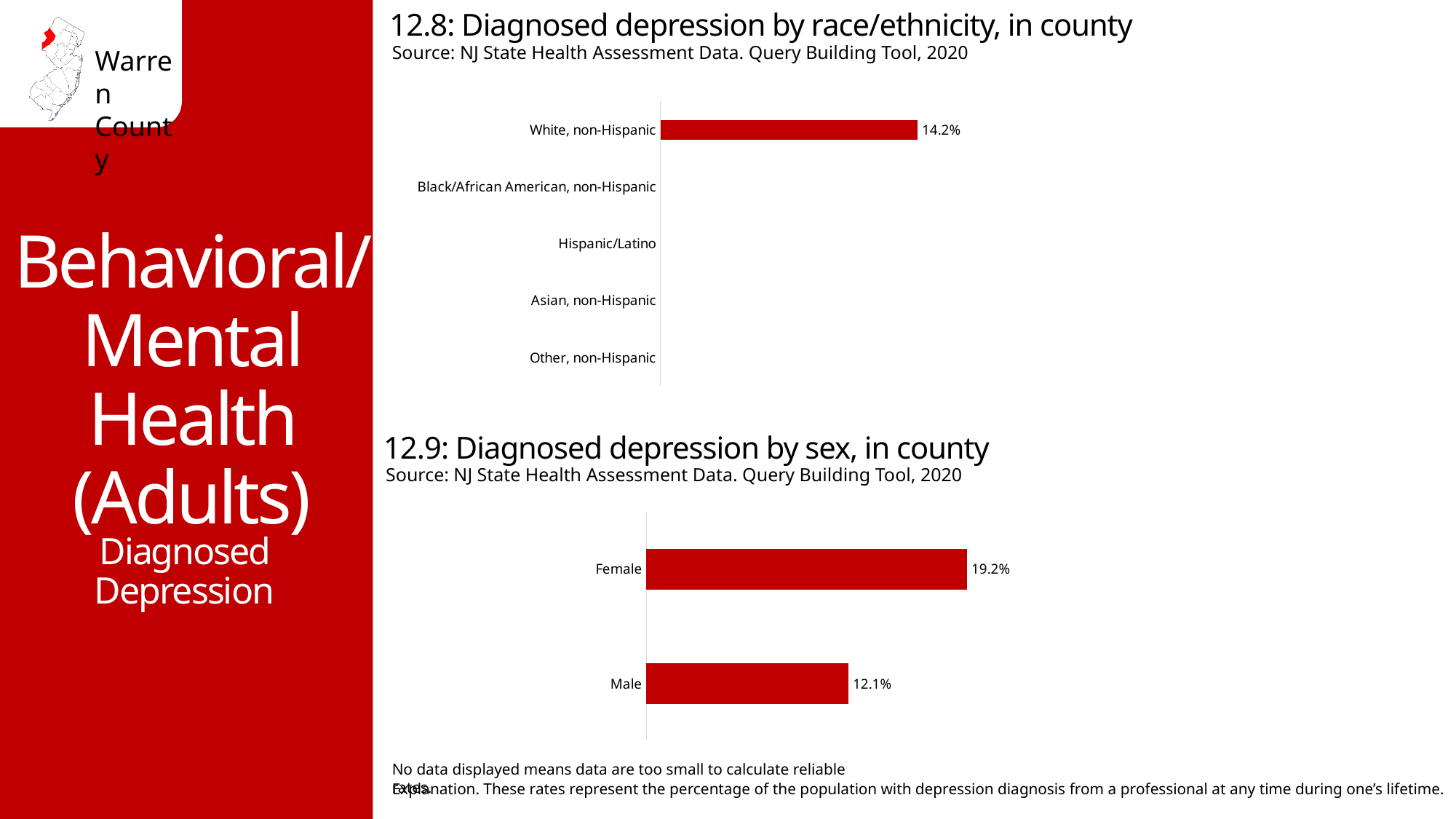
In the chart '12.8: Diagnosed depression by race/ethnicity, in county', what is the value for White, non-Hispanic? 14.2% In the chart '12.9: Diagnosed depression by sex, in county', what is the value for Female? 19.2% In the chart '12.9: Diagnosed depression by sex, in county', is the value for Female or Male larger? Female What kind of chart is '12.9: Diagnosed depression by sex, in county'? Bar chart In the chart '12.8: Diagnosed depression by race/ethnicity, in county', which category is the only one with a bar displayed? White, non-Hispanic In the chart '12.9: Diagnosed depression by sex, in county', how many categories are shown? 2 In the chart '12.9: Diagnosed depression by sex, in county', what is the value for Male? 12.1% In the chart '12.9: Diagnosed depression by sex, in county', which category has the lowest value? Male What kind of chart is '12.8: Diagnosed depression by race/ethnicity, in county'? Bar chart In the chart '12.9: Diagnosed depression by sex, in county', which category has the highest value? Female In the chart '12.8: Diagnosed depression by race/ethnicity, in county', how many race/ethnicity categories are listed on the axis? 5 In the chart '12.9: Diagnosed depression by sex, in county', what is the difference between the Female and Male values? 7.1%